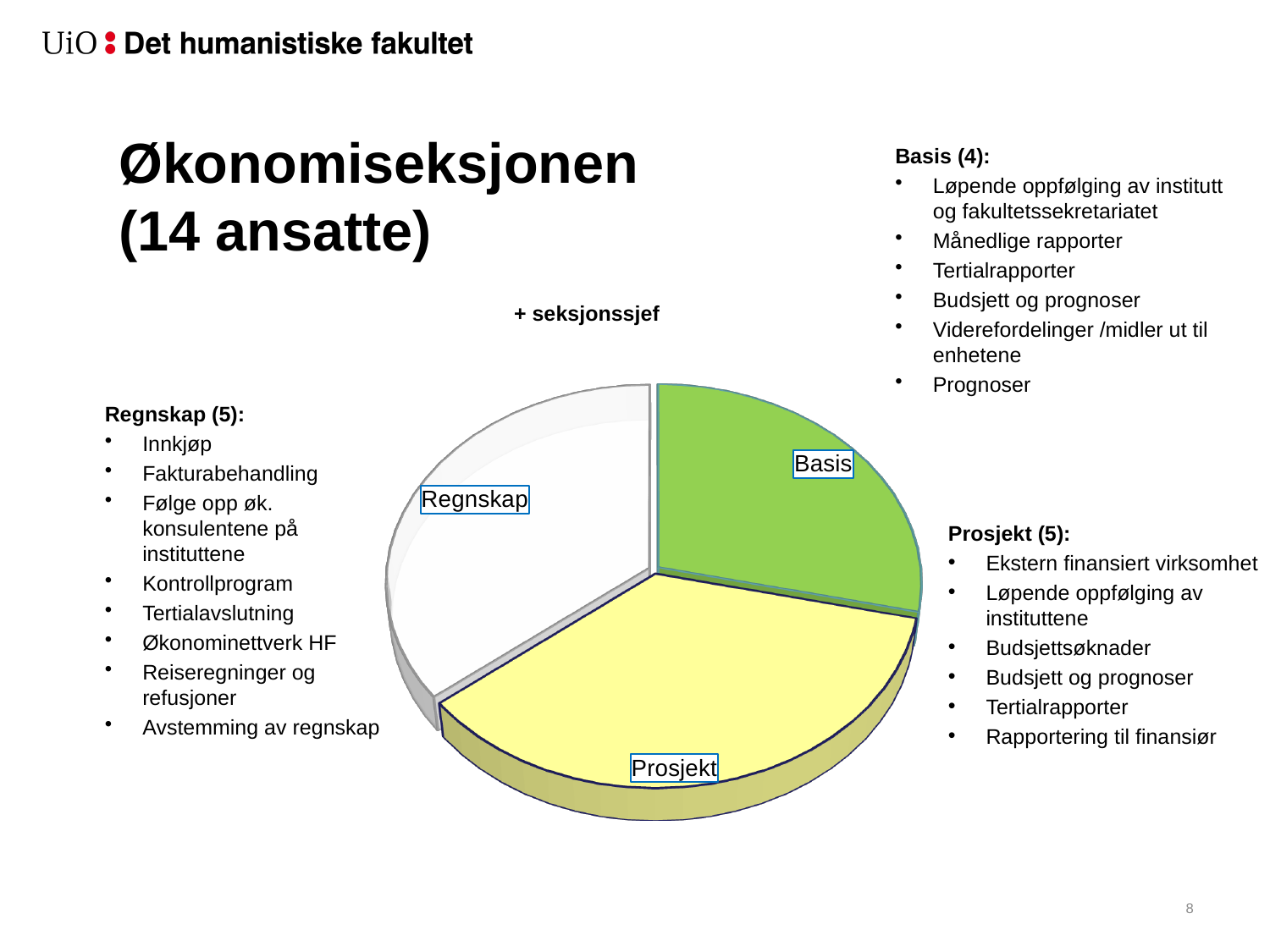
Which slice of the pie chart is pulled out (exploded) from the rest of the pie? Regnskap How many slices does the pie chart have? 3 What colour is the Basis slice of the pie chart? green Which slice is larger in the pie chart, Basis or Prosjekt? Prosjekt What are the labels of the three slices in the pie chart? Basis, Regnskap, Prosjekt Which slice of the pie chart is the smallest? Basis What kind of chart is shown on the slide? pie chart Which slice is larger in the pie chart, Basis or Regnskap? Regnskap